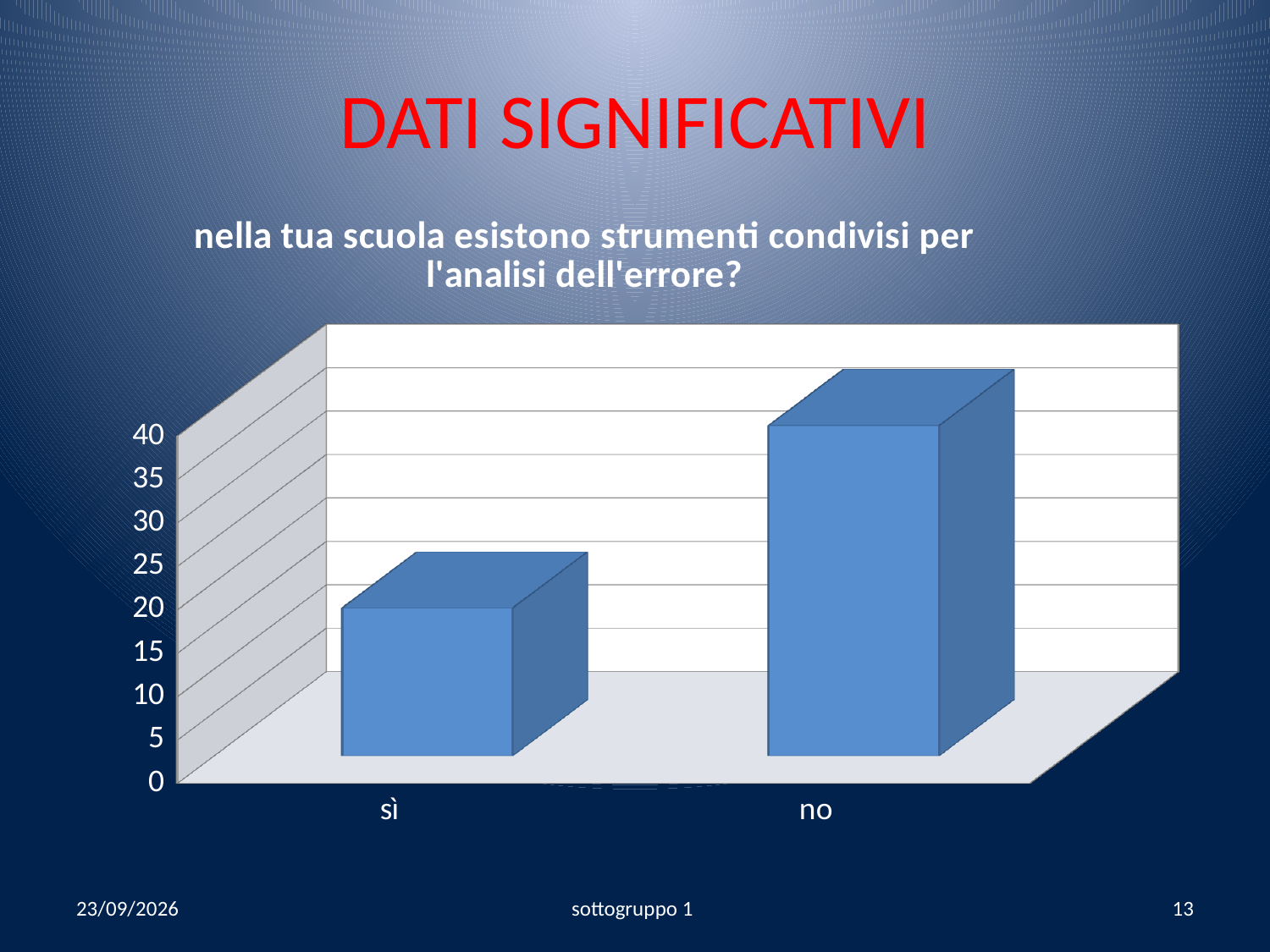
What is the highest value shown on the vertical axis of the chart? 40 Which category has the highest bar in the chart? no Is the value for 'sì' greater or less than 10? greater Is the value for 'no' greater or less than 30? greater Which category has the lowest bar in the chart? sì What kind of chart is shown on the slide? bar chart Which bar is taller, 'sì' or 'no'? no What question does the chart title ask? nella tua scuola esistono strumenti condivisi per l'analisi dell'errore? How many categories are shown on the x axis of the chart? 2 Is the value for 'sì' greater or less than 25? less